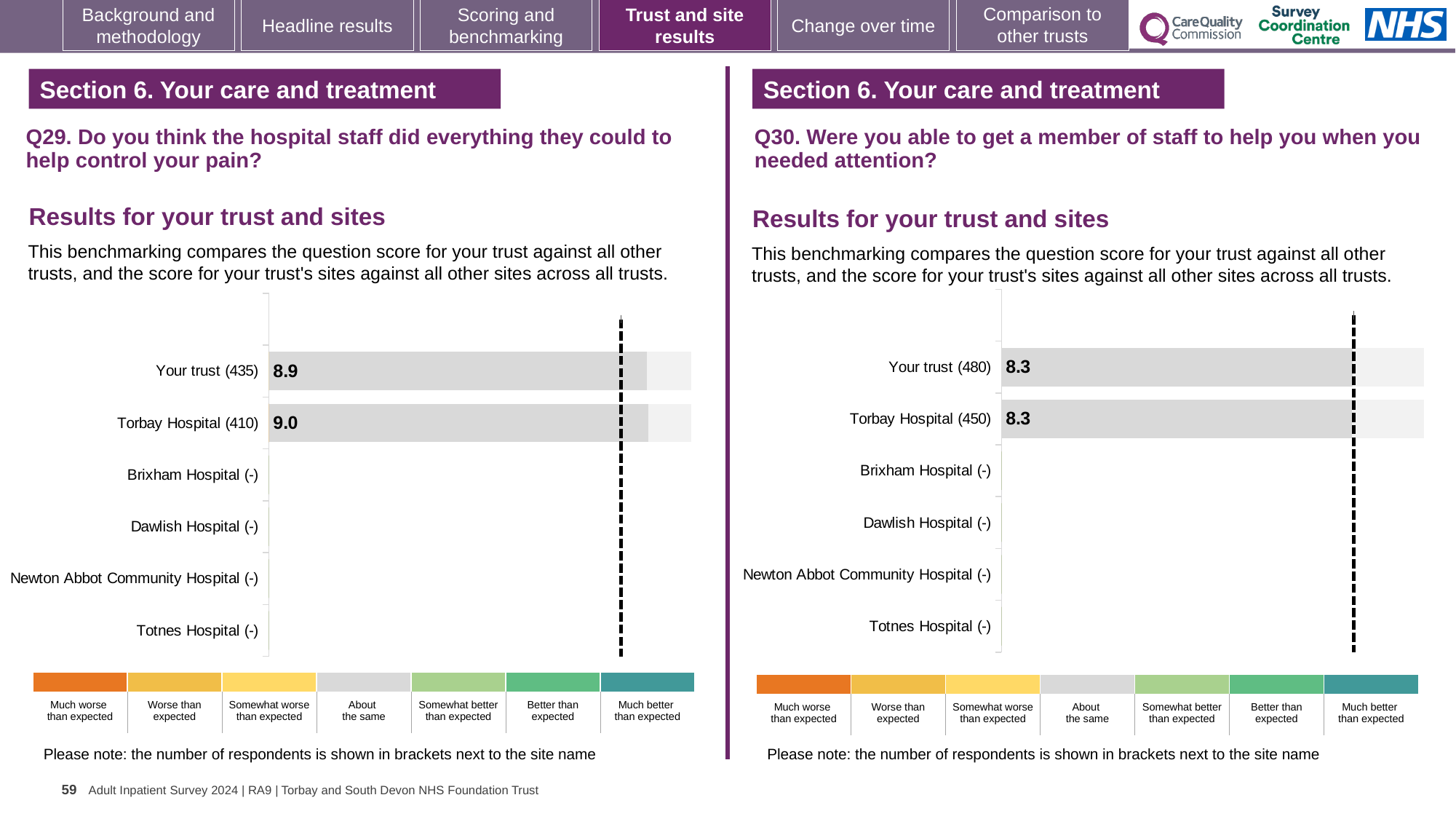
On the Q30 chart (right), what is the score for Your trust? 8.3 How many benchmark categories are shown in the colour key below the Q30 chart (right)? 7 On the Q29 chart (left), what is the difference between the Torbay Hospital score and the Your trust score? 0.1 On the Q29 chart (left), what is the score for Torbay Hospital? 9.0 On the Q30 chart (right), how many site/trust categories are listed on the vertical axis? 6 On the Q29 chart (left), how many respondents are shown in brackets for Your trust? 435 On the Q30 chart (right), what is the score for Torbay Hospital? 8.3 On the Q30 chart (right), how many respondents are shown in brackets for Torbay Hospital? 450 On the Q29 chart (left), what is the score for Your trust? 8.9 On the Q29 chart (left), how many categories have a plotted score bar? 2 On the Q29 chart (left), which has the higher score, Your trust or Torbay Hospital? Torbay Hospital What kind of chart is used on the Q29 (left) side of the slide? Bar chart